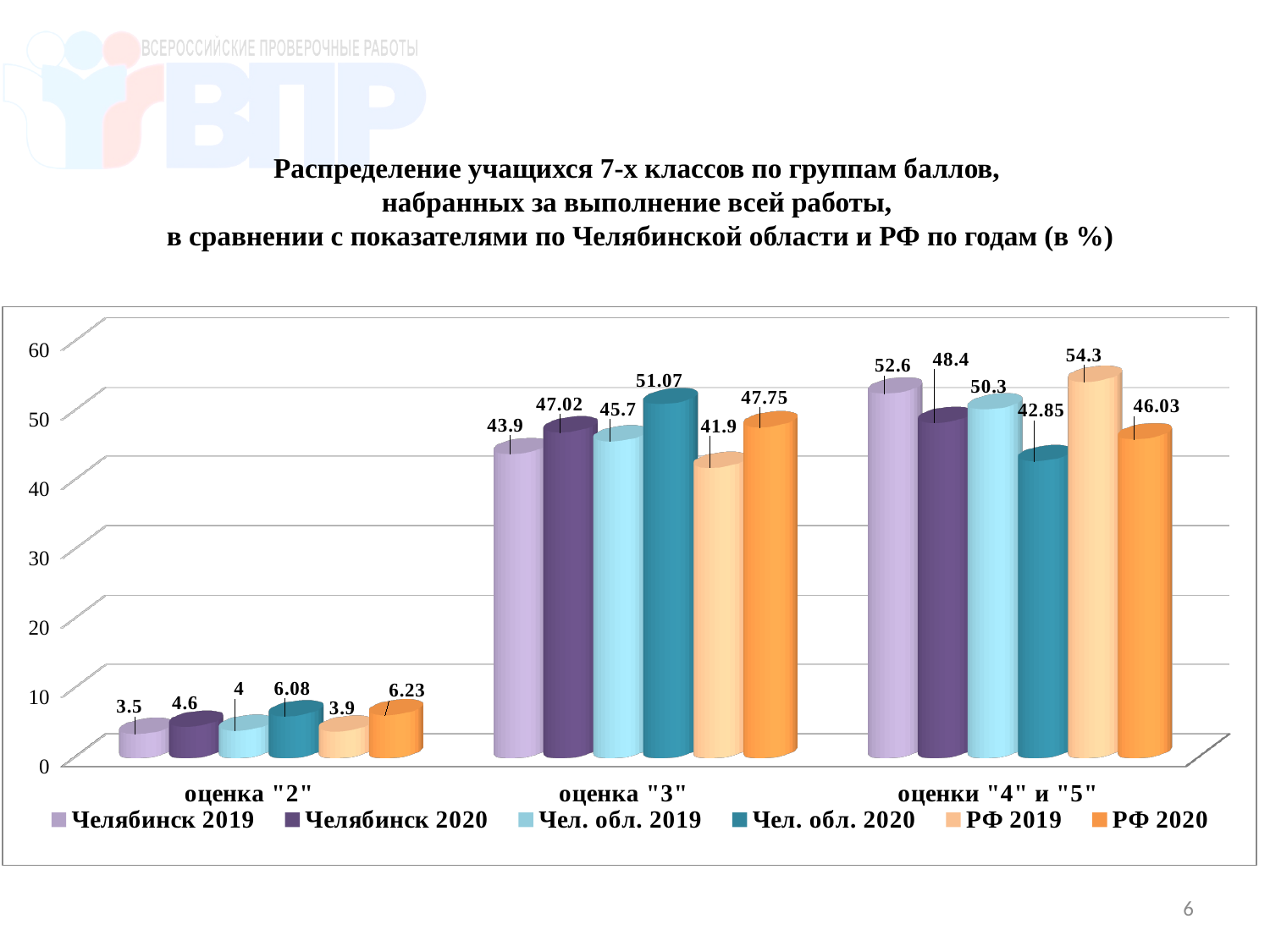
Which series has the lowest value in the оценка "3" category? РФ 2019 What is the value for Чел. обл. 2020 in the оценка "3" category? 51.07 What is the value for Челябинск 2019 in the оценка "2" category? 3.5 How many series does the legend list? 6 What is the difference between Челябинск 2020 and Челябинск 2019 in the оценка "3" category? 3.12 What kind of chart is shown on the slide? bar chart How many categories are shown on the x axis? 3 What is the value for Чел. обл. 2019 in the оценка "2" category? 4 Which is larger in the оценка "2" category: Чел. обл. 2020 or РФ 2020? РФ 2020 Which series has the highest value in the оценки "4" и "5" category? РФ 2019 What is the value for РФ 2019 in the оценки "4" и "5" category? 54.3 Is the value for Челябинск 2019 in the оценки "4" и "5" category greater or less than 50? greater